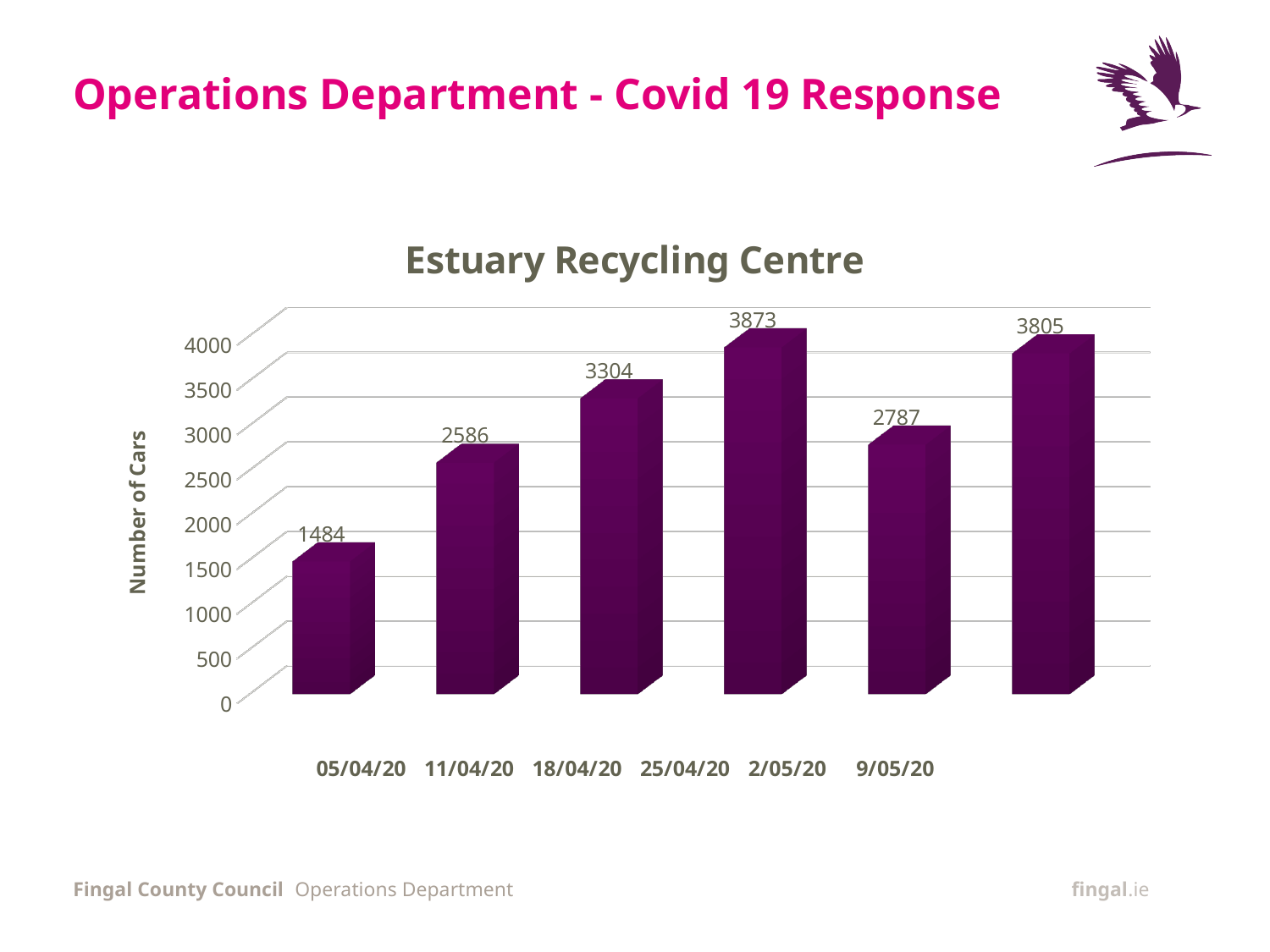
What is the number of cars for 9/05/20? 3805 How many dates are shown on the x axis? 6 What is the number of cars for 25/04/20? 3873 Which date has the lowest number of cars? 05/04/20 What kind of chart is shown on the slide? Bar chart Is the value for 11/04/20 greater or less than 2500? greater What is the title of the chart? Estuary Recycling Centre What is the label on the vertical axis? Number of Cars Which has more cars, 2/05/20 or 9/05/20? 9/05/20 What is the number of cars for 05/04/20? 1484 What is the difference in number of cars between 18/04/20 and 11/04/20? 718 Which date has the highest number of cars? 25/04/20